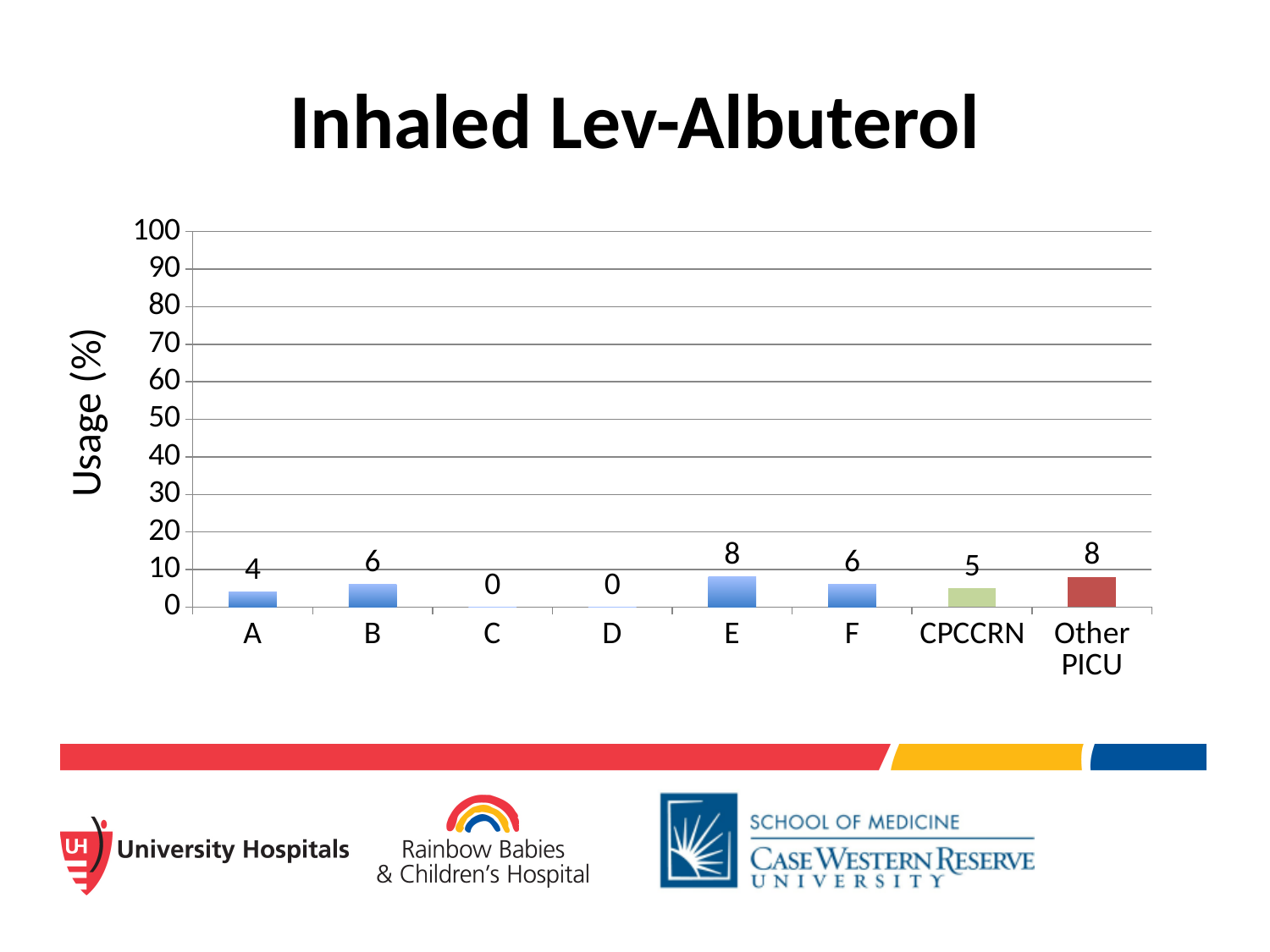
What is the difference between the usage values for Other PICU and CPCCRN? 3 What is the usage value for CPCCRN? 5 What kind of chart is shown on the slide? bar chart Is the usage value for F greater or less than 10? less What is the label of the y axis? Usage (%) Which categories have the lowest usage value? C and D What is the usage value for A? 4 Which has a larger usage value, B or CPCCRN? B How many categories are shown on the x axis? 8 What is the title of the chart? Inhaled Lev-Albuterol What is the usage value for Other PICU? 8 What is the difference between the usage values for E and A? 4